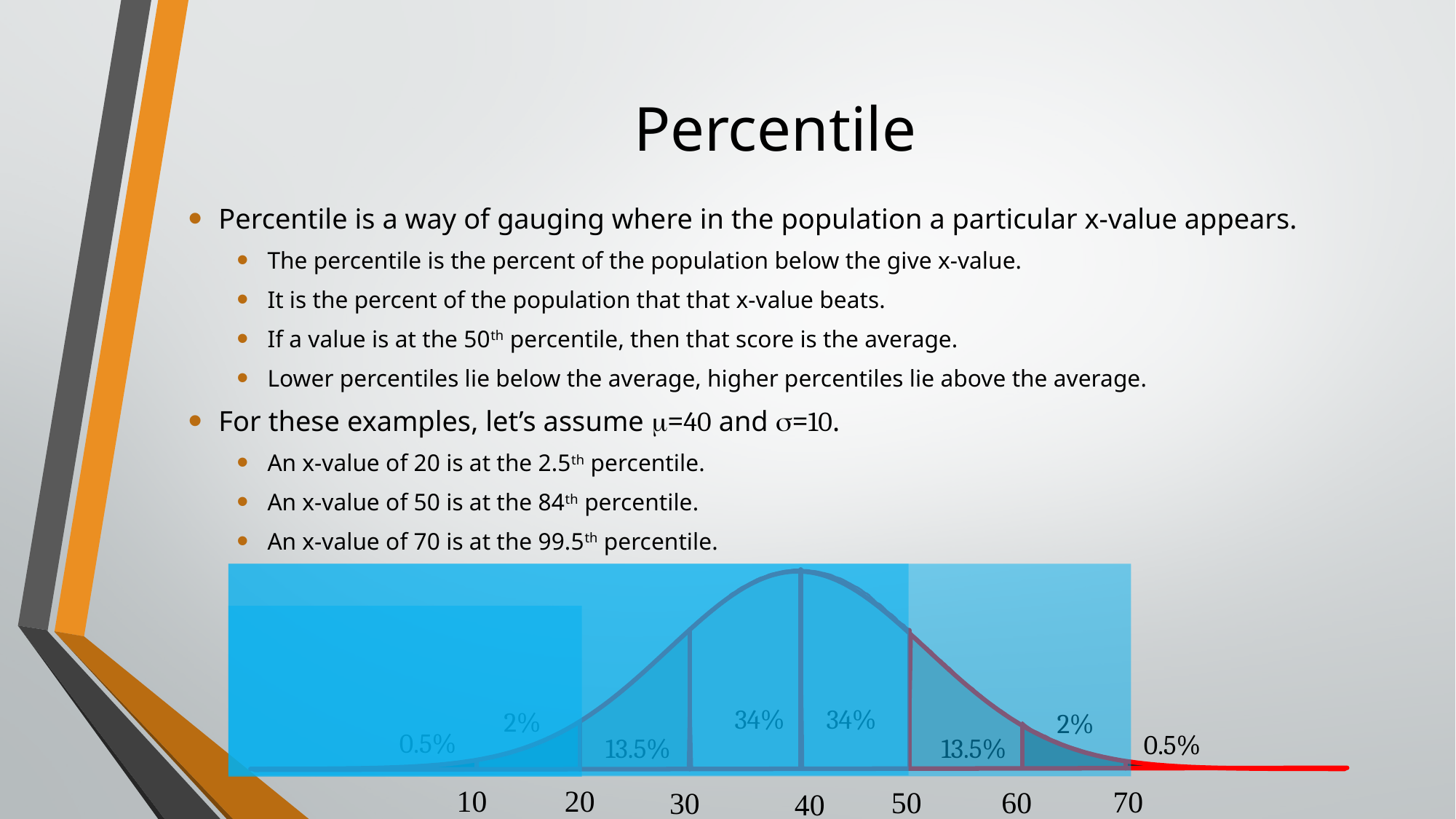
What is the smallest percentage label shown on the curve? 0.5% What is the combined percentage for the regions between 30 and 50 on the x axis? 68% At which x-axis value does the curve reach its peak? 40 Which is larger: the percentage for the region between 20 and 30 or the region between 60 and 70? the region between 20 and 30 (13.5%) What kind of chart is shown at the bottom of the slide? a normal distribution (bell) curve What is the difference between the percentage for the region between 40 and 50 and the region between 50 and 60? 20.5% What percentage label is shown for the region between 60 and 70 on the x axis? 2% What percentage label is shown for the region between 50 and 60 on the x axis? 13.5% What percentage label is shown for the region between 30 and 40 on the x axis? 34% What is the largest percentage label shown on the curve? 34% How many tick labels are shown on the x axis of the curve? 7 What percentage label is shown for the region beyond 70 on the x axis? 0.5%